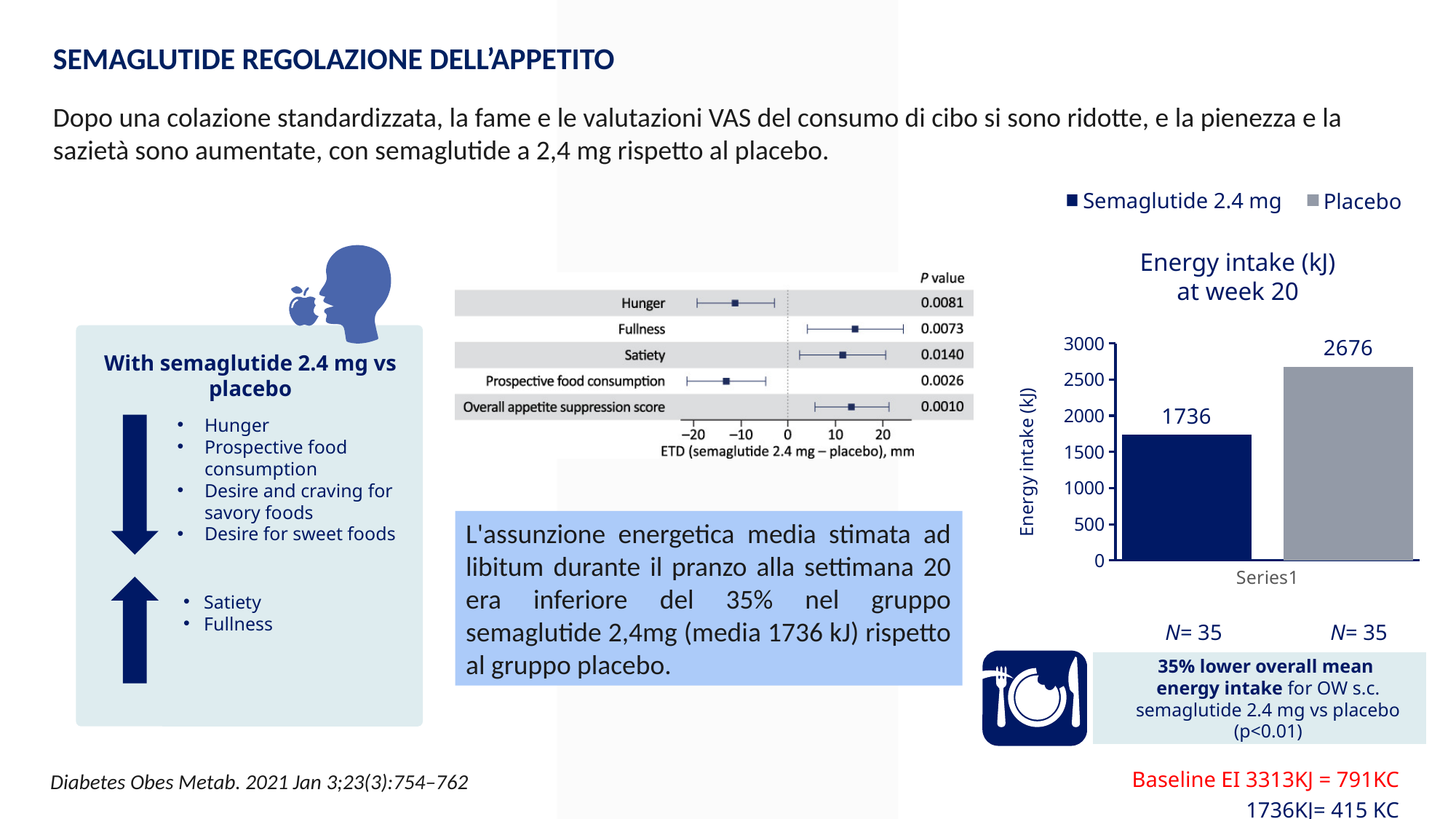
In the 'Energy intake (kJ) at week 20' chart, what is the label on the vertical axis? Energy intake (kJ) In the forest plot in the middle of the slide, what is the P value for Hunger? 0.0081 In the 'Energy intake (kJ) at week 20' chart, how many series does the legend list? 2 In the 'Energy intake (kJ) at week 20' chart, what is the value for Semaglutide 2.4 mg? 1736 In the 'Energy intake (kJ) at week 20' chart, which group has the higher energy intake? Placebo In the forest plot in the middle of the slide, which outcome has the lowest P value? Overall appetite suppression score In the forest plot in the middle of the slide, how many outcomes are plotted? 5 In the 'Energy intake (kJ) at week 20' chart, which group has the lower energy intake? Semaglutide 2.4 mg In the 'Energy intake (kJ) at week 20' chart, what is the value for Placebo? 2676 In the 'Energy intake (kJ) at week 20' chart, what is the difference between the Placebo and Semaglutide 2.4 mg values? 940 What kind of chart is the 'Energy intake (kJ) at week 20' chart? bar chart In the 'Energy intake (kJ) at week 20' chart, is the value for Semaglutide 2.4 mg greater or less than 2000? less